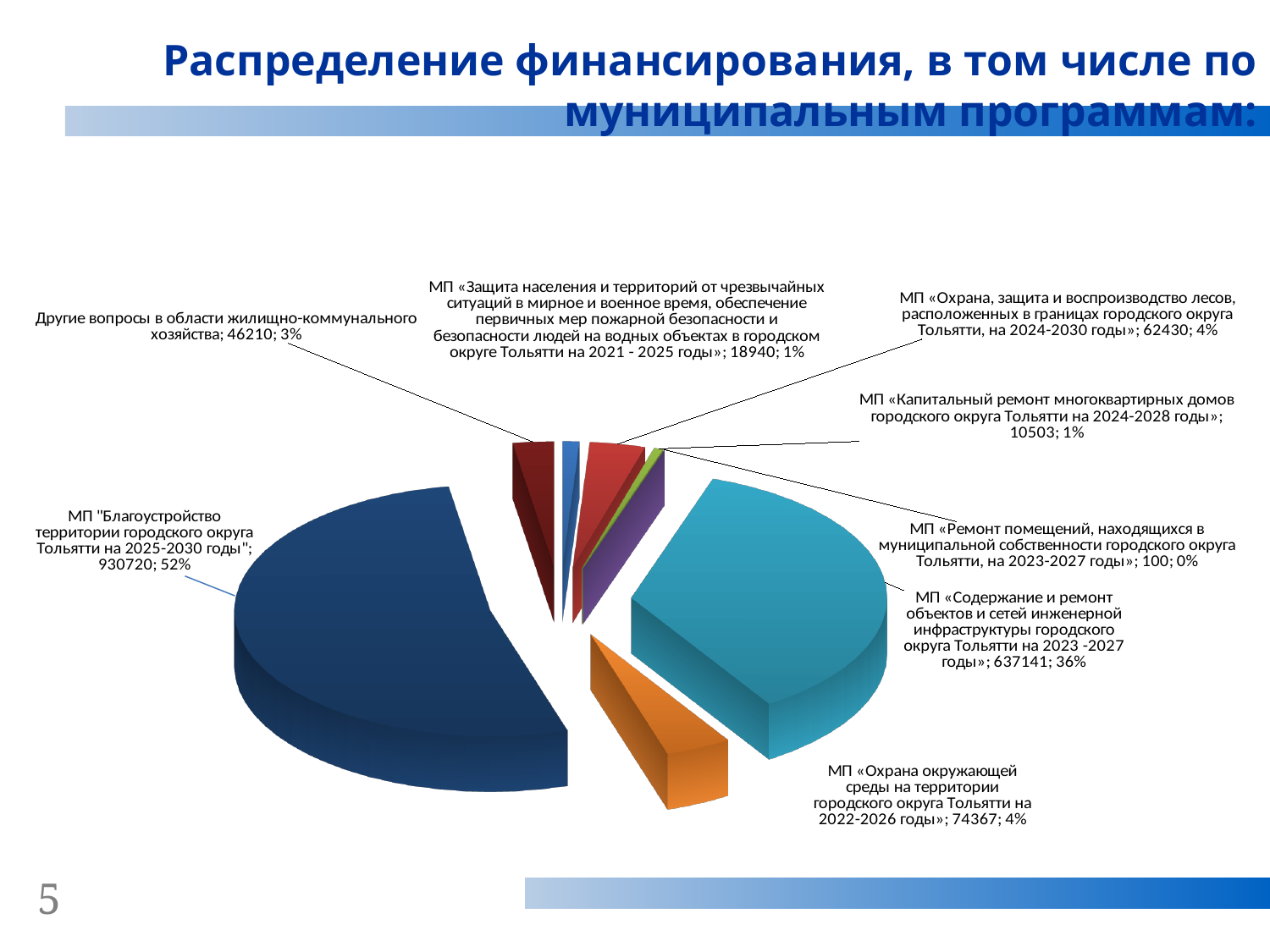
What is the difference between the values for МП «Охрана окружающей среды на территории городского округа Тольятти на 2022-2026 годы» and МП «Охрана, защита и воспроизводство лесов, расположенных в границах городского округа Тольятти, на 2024-2030 годы»? 11937 How many slices does the pie chart have? 8 What is the value for МП «Содержание и ремонт объектов и сетей инженерной инфраструктуры городского округа Тольятти на 2023-2027 годы»? 637141 What is the value for МП «Охрана окружающей среды на территории городского округа Тольятти на 2022-2026 годы»? 74367 What kind of chart is shown on the slide? Pie chart What share of the pie does МП «Охрана, защита и воспроизводство лесов, расположенных в границах городского округа Тольятти, на 2024-2030 годы» represent? 4% Which category has the largest slice of the pie? МП "Благоустройство территории городского округа Тольятти на 2025-2030 годы" What is the value for Другие вопросы в области жилищно-коммунального хозяйства? 46210 What share of the pie does МП «Содержание и ремонт объектов и сетей инженерной инфраструктуры городского округа Тольятти на 2023-2027 годы» represent? 36% Which is larger: the value for МП «Защита населения и территорий от чрезвычайных ситуаций...» or МП «Капитальный ремонт многоквартирных домов городского округа Тольятти на 2024-2028 годы»? МП «Защита населения и территорий от чрезвычайных ситуаций...» What is the value for МП "Благоустройство территории городского округа Тольятти на 2025-2030 годы"? 930720 Which category has the smallest slice of the pie? МП «Ремонт помещений, находящихся в муниципальной собственности городского округа Тольятти, на 2023-2027 годы»